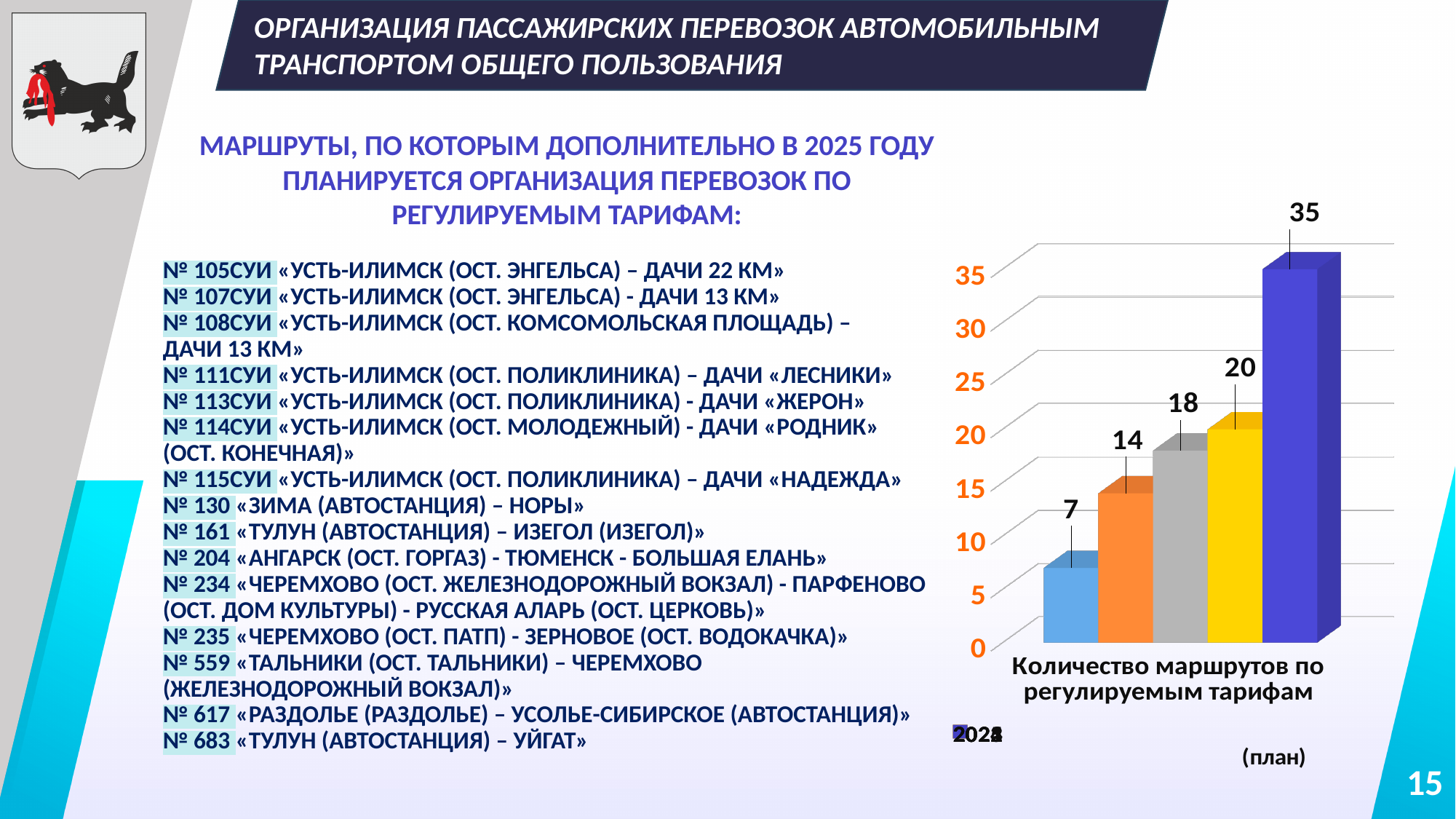
What kind of chart is shown on the slide? bar chart What is the value of the orange bar in the chart? 14 Do the bar values rise or fall from left to right in the chart? rise What is the value of the grey bar in the chart? 18 What is the highest value shown in the chart? 35 What is the value of the leftmost (light blue) bar in the chart? 7 What is the value of the yellow bar in the chart? 20 What is the value of the rightmost (dark blue) bar in the chart? 35 What is the lowest value shown in the chart? 7 What is the category label printed under the bars in the chart? Количество маршрутов по регулируемым тарифам What is the difference between the rightmost bar and the leftmost bar in the chart? 28 How many bars are plotted in the chart? 5